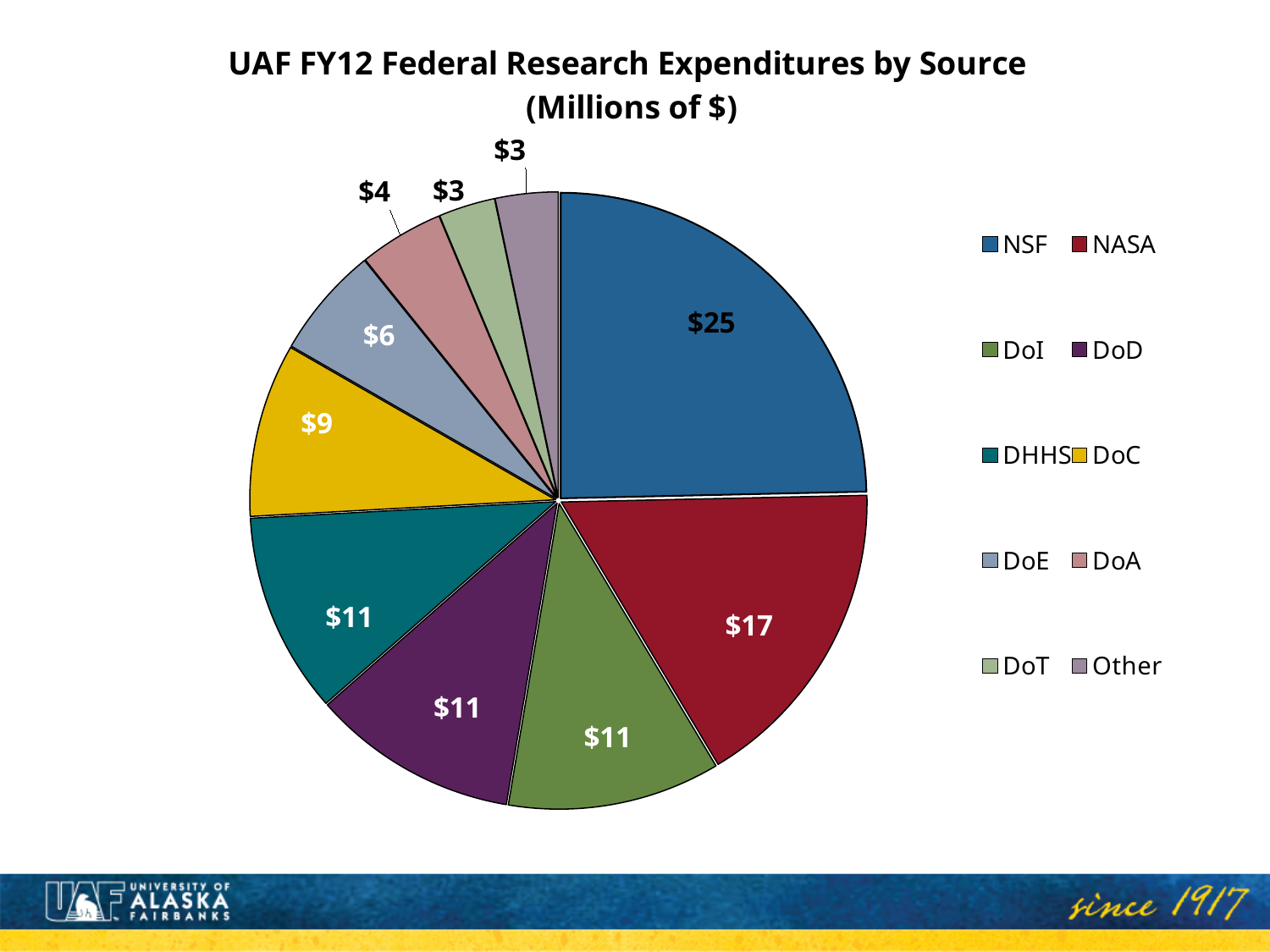
What kind of chart is shown on the slide? Pie chart What is the value for NASA? $17 Which source has the largest slice? NSF What is the title of the chart? UAF FY12 Federal Research Expenditures by Source (Millions of $) What is the difference between the NSF and NASA values? $8 Which is larger, the value for NASA or the value for DoC? NASA What share of the total does the NSF slice represent? 25% How many sources are shown in the pie chart? 10 What is the value for DoE? $6 What is the value for NSF? $25 What is the value for DoC? $9 What is the value for DoA? $4